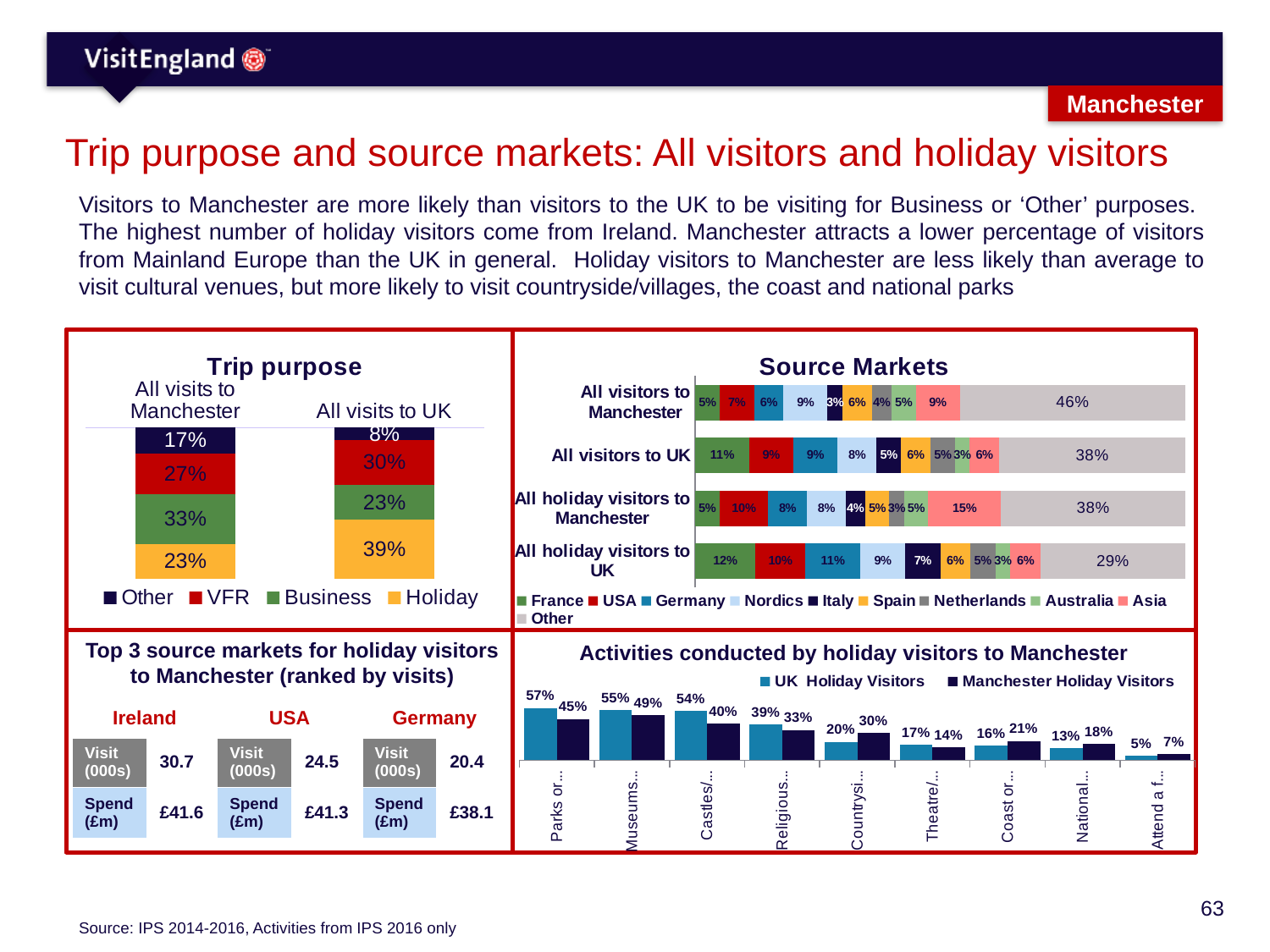
In the Activities chart, what percentage of Manchester holiday visitors visit parks? 45% In the Trip purpose chart, how many series does the legend list? 4 In the Activities chart, which activity has the highest value for UK Holiday Visitors? Parks In the Source Markets chart, how many source markets does the legend list? 10 In the Source Markets chart, what percentage of all holiday visitors to Manchester come from Asia? 15% In the Trip purpose chart, what percentage of all visits to Manchester are for Business? 33% In the Source Markets chart, what percentage of all visitors to Manchester come from 'Other' markets? 46% In the Trip purpose chart, what percentage of all visits to the UK are Holiday visits? 39% In the Source Markets chart, which is larger: the France share of all holiday visitors to the UK or the France share of all holiday visitors to Manchester? All holiday visitors to UK In the Trip purpose chart, what is the difference between the 'Other' share for all visits to Manchester and for all visits to the UK? 9 percentage points In the Activities chart, what is the difference between UK Holiday Visitors and Manchester Holiday Visitors for Castles? 14 percentage points In the Top 3 source markets panel, what is the spend (£m) for holiday visitors from Germany? £38.1